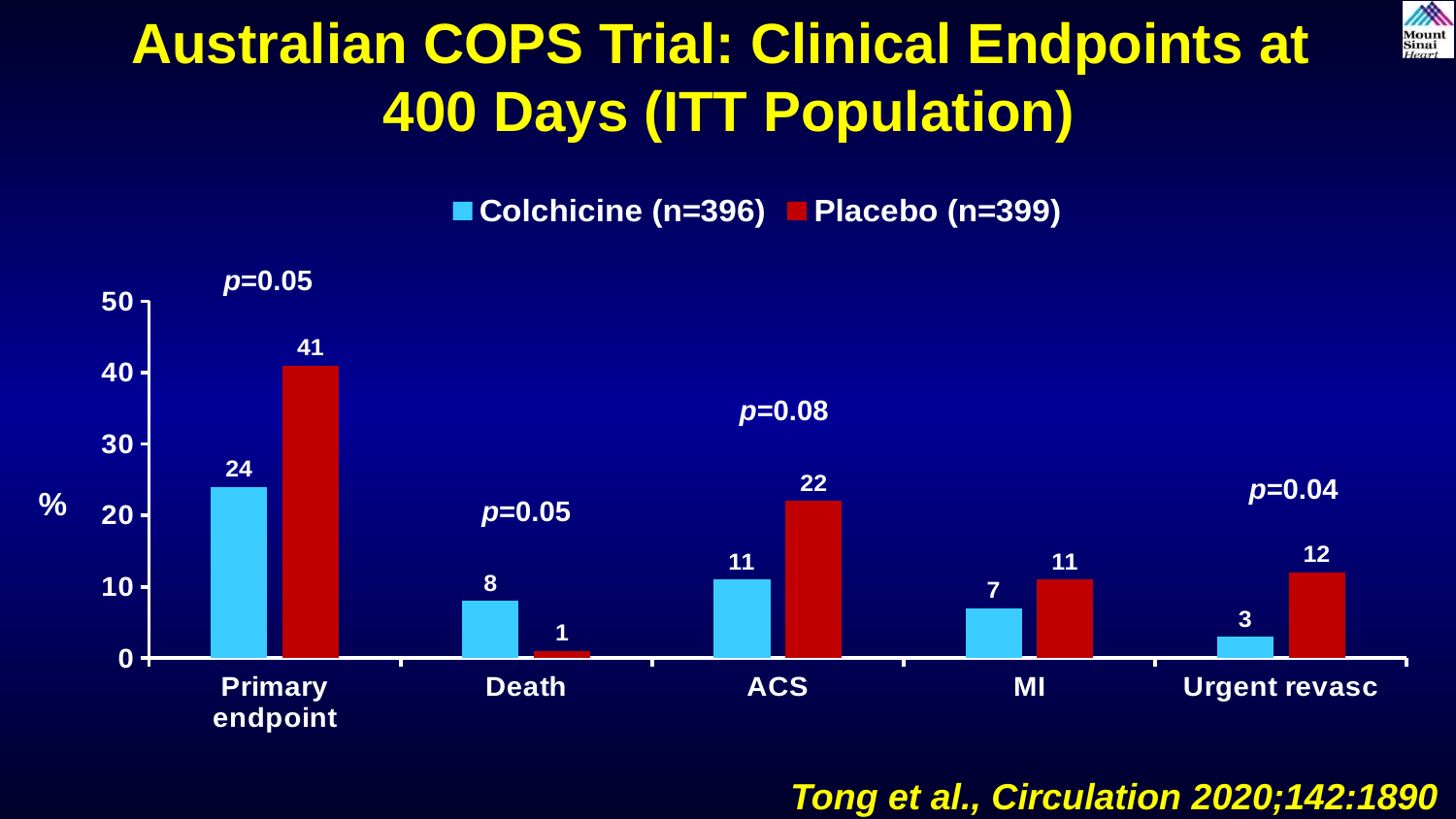
How many series does the legend list? 2 What kind of chart is shown on the slide? Bar chart Which category has the lowest Colchicine (n=396) value? Urgent revasc Which is larger for Death: the Colchicine (n=396) value or the Placebo (n=399) value? Colchicine (n=396) How many categories are shown on the x axis? 5 What is the difference between the Placebo (n=399) and Colchicine (n=396) values for the Primary endpoint? 17 Which category has the highest Placebo (n=399) value? Primary endpoint What p-value is shown above the Urgent revasc bars? p=0.04 What is the Colchicine (n=396) value for Urgent revasc? 3 What is the Placebo (n=399) value for the Primary endpoint? 41 What is the Colchicine (n=396) value for Death? 8 What is the Placebo (n=399) value for ACS? 22